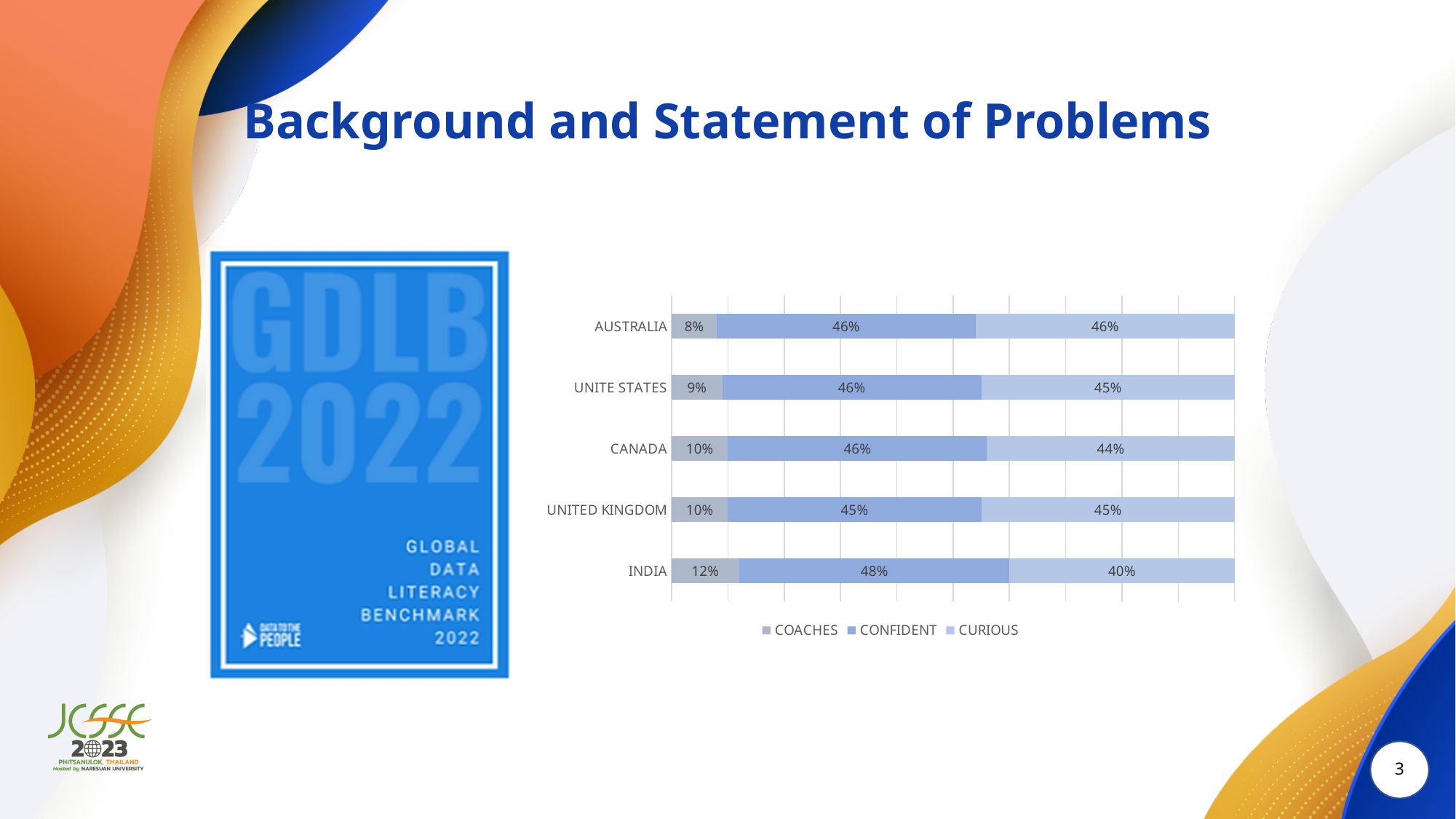
What is the COACHES value for INDIA? 12% Which category has the highest COACHES value? INDIA What is the total of the stacked bar for CANADA? 100% What kind of chart is shown on the slide? Stacked bar chart How many series does the legend list? 3 How many categories are shown on the chart? 5 What is the difference between the CONFIDENT value for INDIA and the CONFIDENT value for UNITED KINGDOM? 3% Which is larger, the CURIOUS value for AUSTRALIA or the CURIOUS value for INDIA? AUSTRALIA What is the CONFIDENT value for UNITED KINGDOM? 45% Which category has the lowest COACHES value? AUSTRALIA What is the CURIOUS value for CANADA? 44% Which category has the lowest CURIOUS value? INDIA